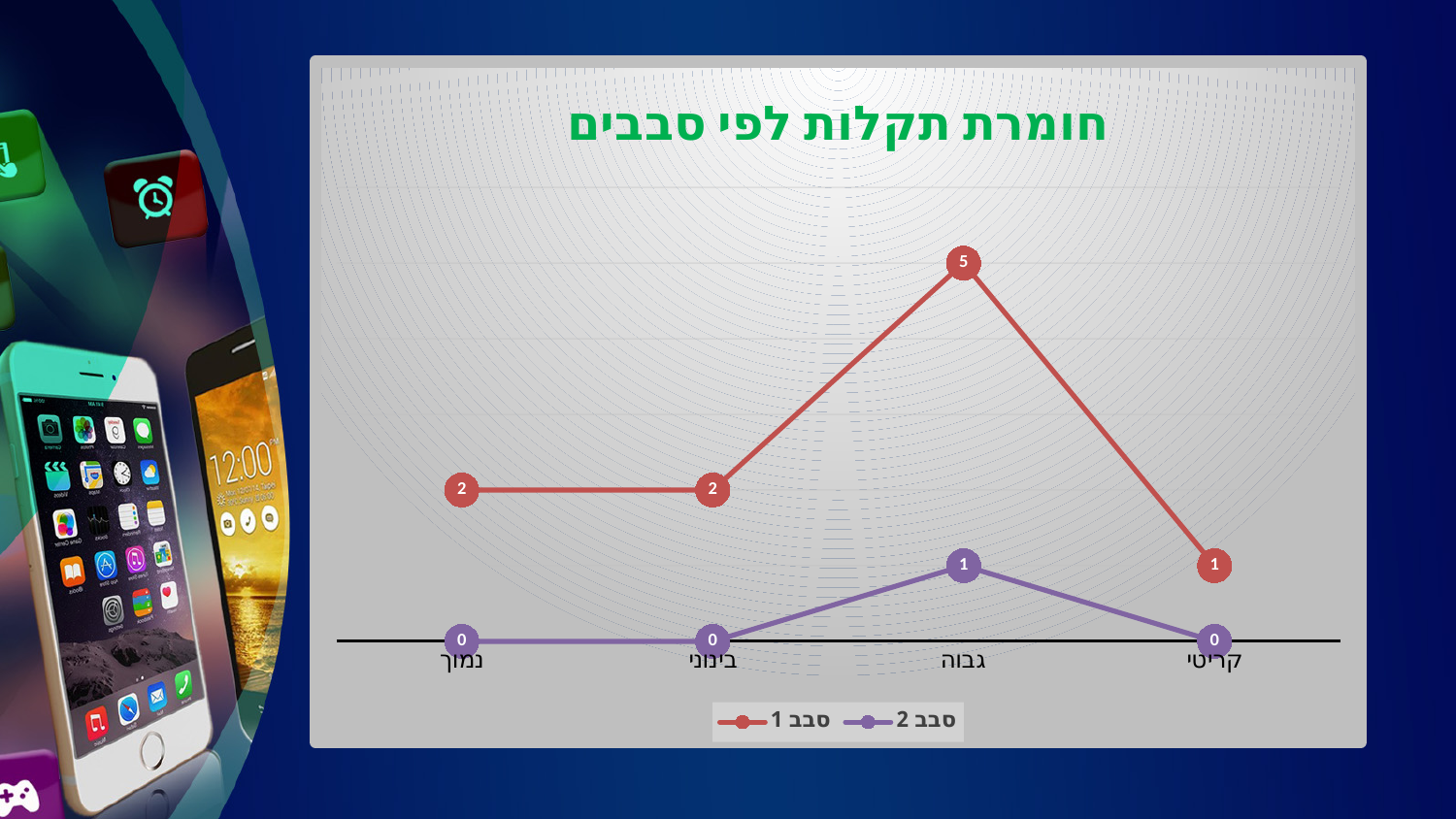
How many series does the legend list? 2 What is the title of the chart? חומרת תקלות לפי סבבים Which series has the larger value at בינוני, סבב 1 or סבב 2? סבב 1 Which category has the lowest value for סבב 1? קריטי What is the value for סבב 2 at גבוה? 1 Which category has the highest value for סבב 1? גבוה What type of chart is shown on the slide? Line chart What is the value for סבב 1 at נמוך? 2 What is the value for סבב 1 at קריטי? 1 How many categories are shown on the x axis? 4 What is the difference between סבב 1 and סבב 2 at גבוה? 4 What is the value for סבב 1 at גבוה? 5